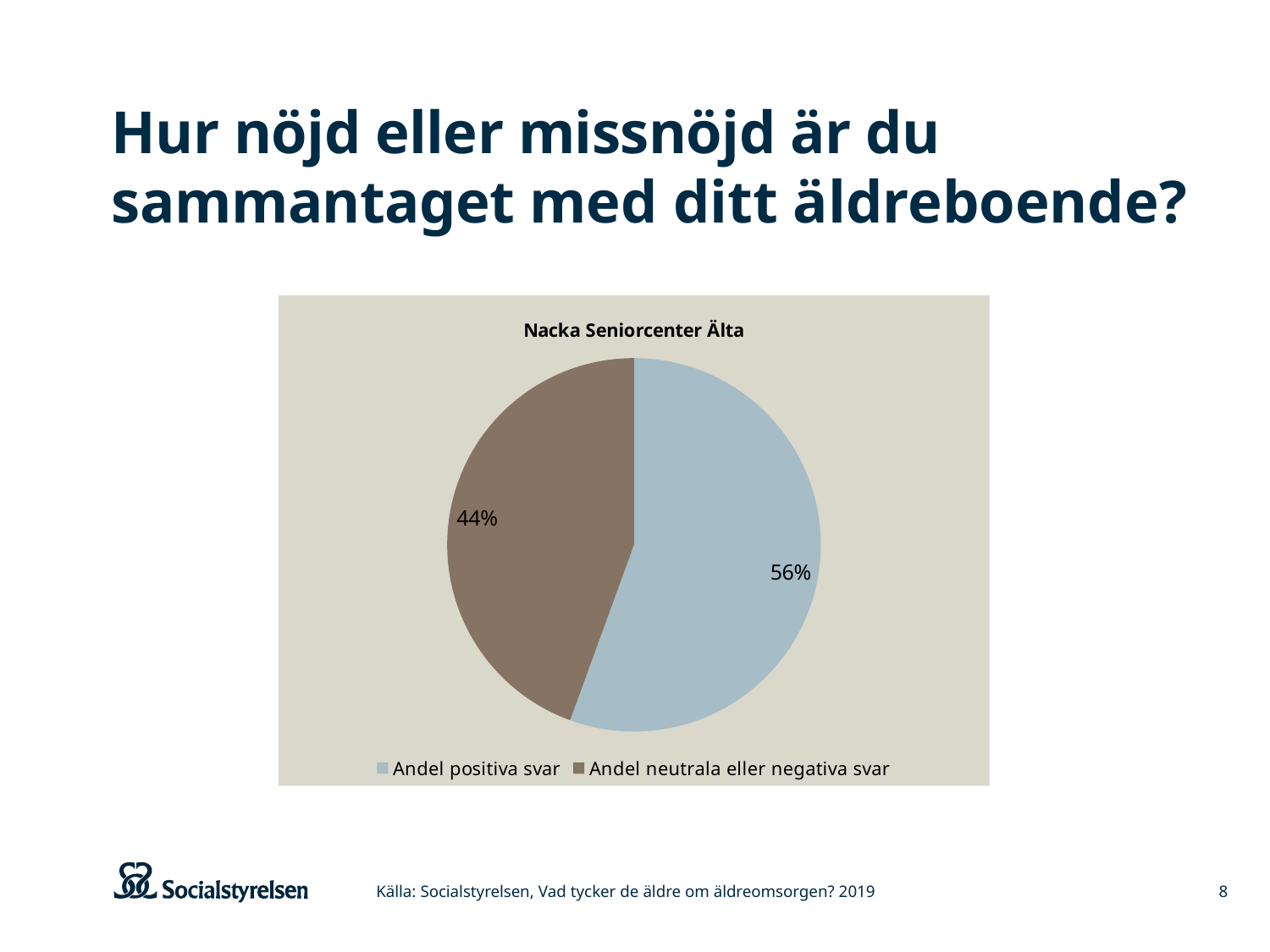
Which is larger, 'Andel positiva svar' or 'Andel neutrala eller negativa svar'? Andel positiva svar What share of the pie is 'Andel neutrala eller negativa svar'? 44% What kind of chart is shown on the slide? Pie chart How many slices does the pie chart have? 2 Is the share for 'Andel positiva svar' greater or less than 50%? greater Which slice is the smallest? Andel neutrala eller negativa svar What is the chart's title? Nacka Seniorcenter Älta What share of the pie is 'Andel positiva svar'? 56% How many entries does the legend list? 2 Which slice is the largest? Andel positiva svar Which legend entry is shown in the brown colour? Andel neutrala eller negativa svar What is the difference in percentage points between 'Andel positiva svar' and 'Andel neutrala eller negativa svar'? 12 percentage points